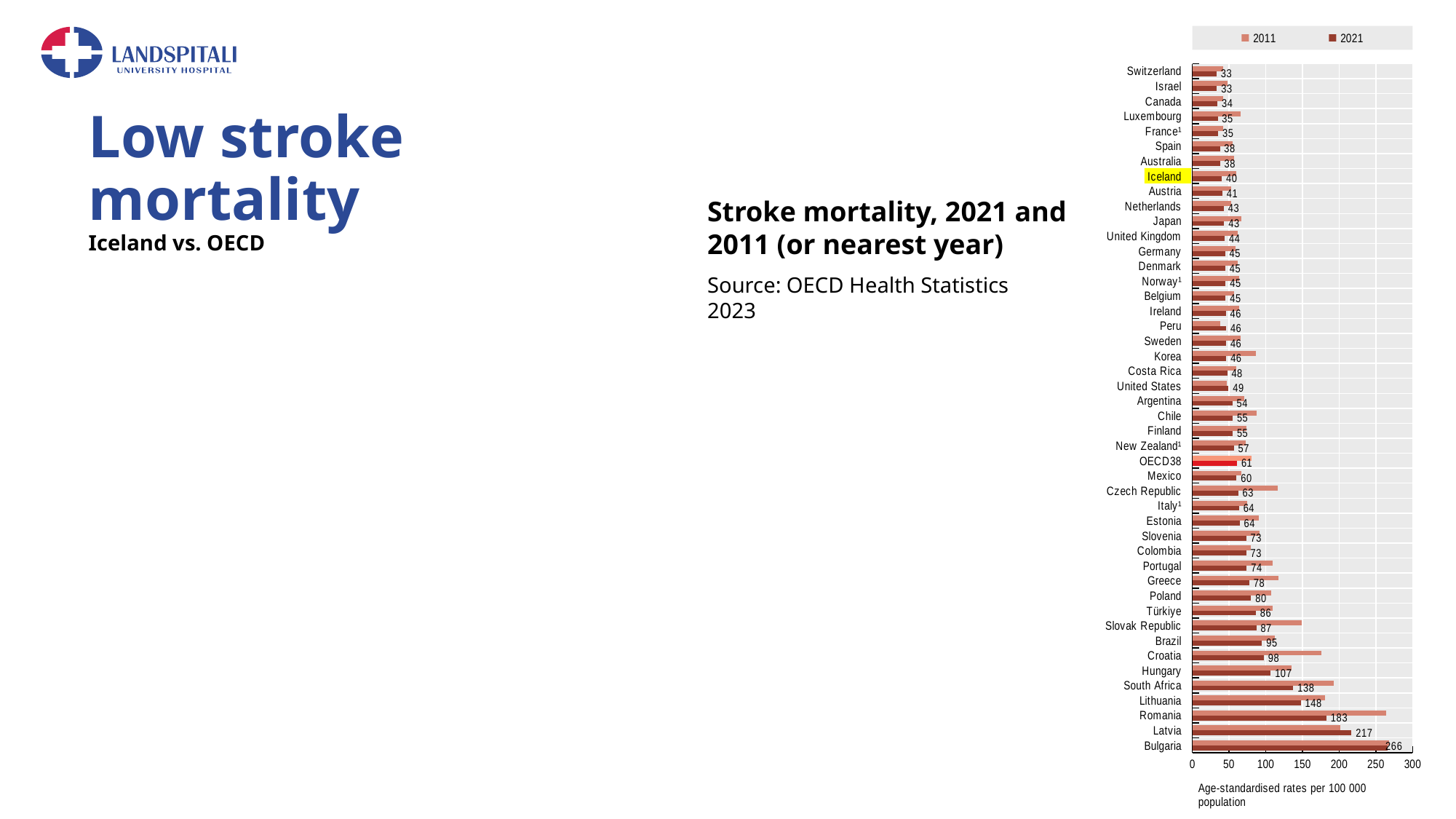
What is the difference between the 2021 stroke mortality rates of Bulgaria and Latvia? 49 Which has a higher 2021 stroke mortality rate, Iceland or OECD38? OECD38 What is the difference between the 2021 stroke mortality rates of OECD38 and Iceland? 21 What is the 2021 stroke mortality rate for OECD38? 61 What is the 2021 stroke mortality rate for Bulgaria? 266 How many series does the legend list? 2 What is the title of the chart? Stroke mortality, 2021 and 2011 (or nearest year) Which country has the highest 2021 stroke mortality rate? Bulgaria What is the 2021 stroke mortality rate for Iceland? 40 What kind of chart is shown on the slide? Bar chart What is the 2021 stroke mortality rate for Lithuania? 148 Is the 2011 value for Romania greater or less than 250? greater